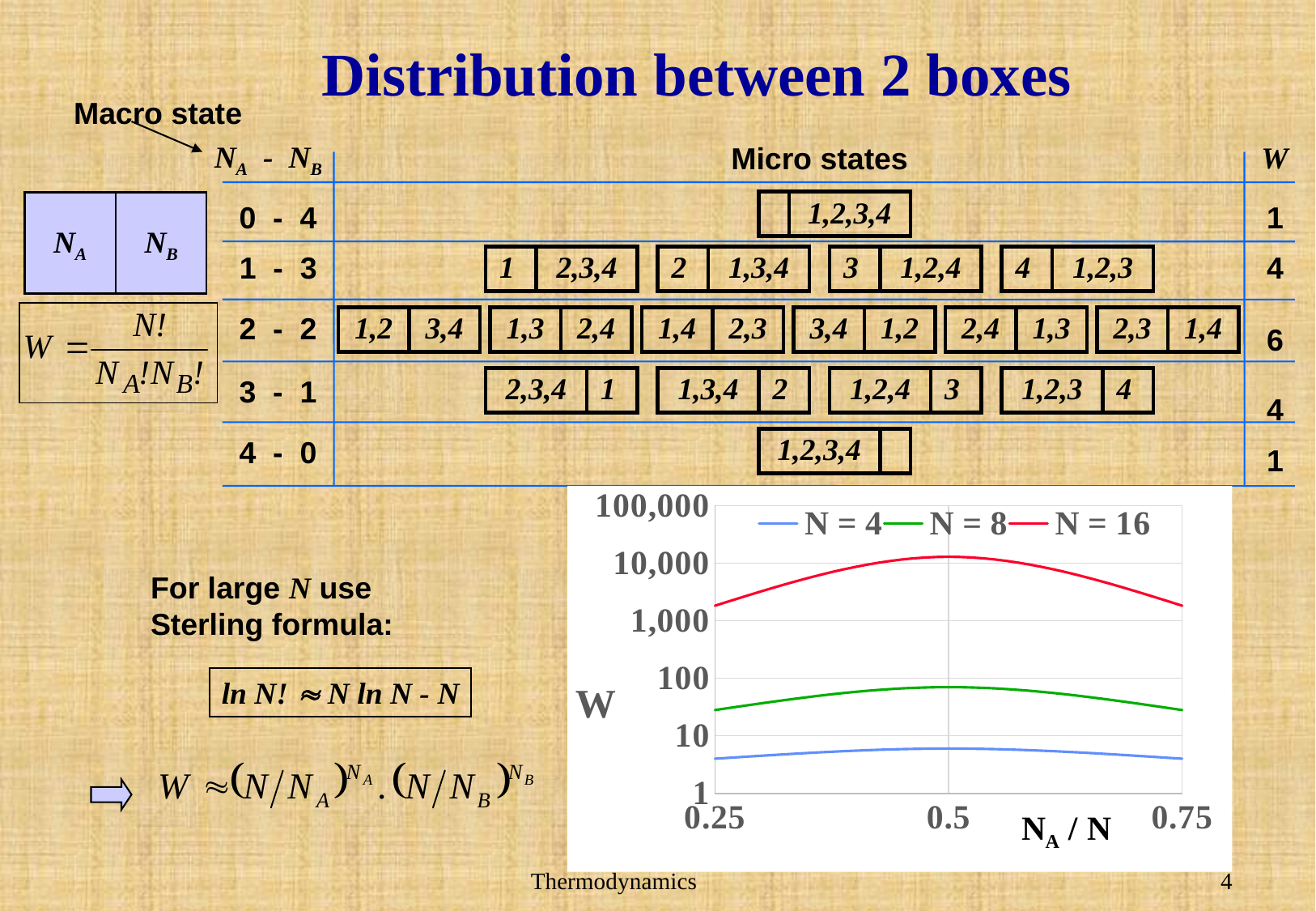
Is the value of W for N = 16 at N_A / N = 0.5 greater or less than 10,000? greater How many series does the chart's legend list? 3 Is the value of W for N = 8 at N_A / N = 0.25 greater or less than 10? greater What label is shown on the chart's x axis? N_A / N Which series has the lowest values of W on the chart? N = 4 Which series reaches the highest value of W on the chart? N = 16 At N_A / N = 0.5, which series has the larger value of W: N = 16 or N = 4? N = 16 What kind of chart is shown on the slide? line chart Is the value of W for N = 8 at N_A / N = 0.5 greater or less than 100? less How does W for N = 16 change as N_A / N goes from 0.25 to 0.75? rises to a peak at 0.5, then falls